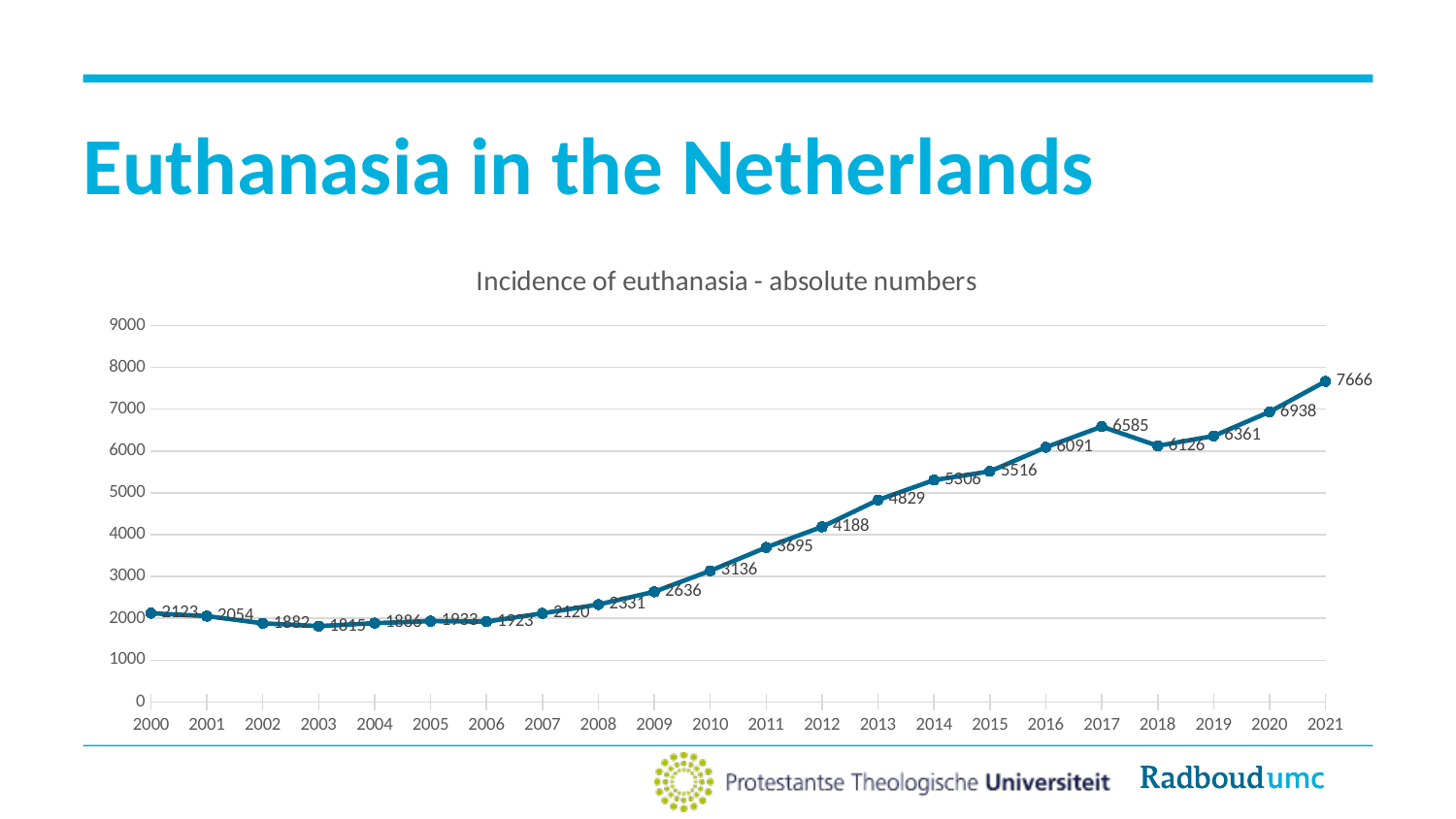
Which year has the lowest value? 2003 What is the value for 2012? 4188 What is the value for 2021? 7666 What is the value for 2017? 6585 Do the values rise or fall from 2010 to 2017? rise What is the value for 2010? 3136 Which year has the larger value, 2017 or 2018? 2017 What is the difference between the values for 2021 and 2020? 728 Is the value for 2014 greater or less than 5000? greater How many years are plotted on the x axis? 22 What kind of chart is this? line chart Which year has the highest value? 2021